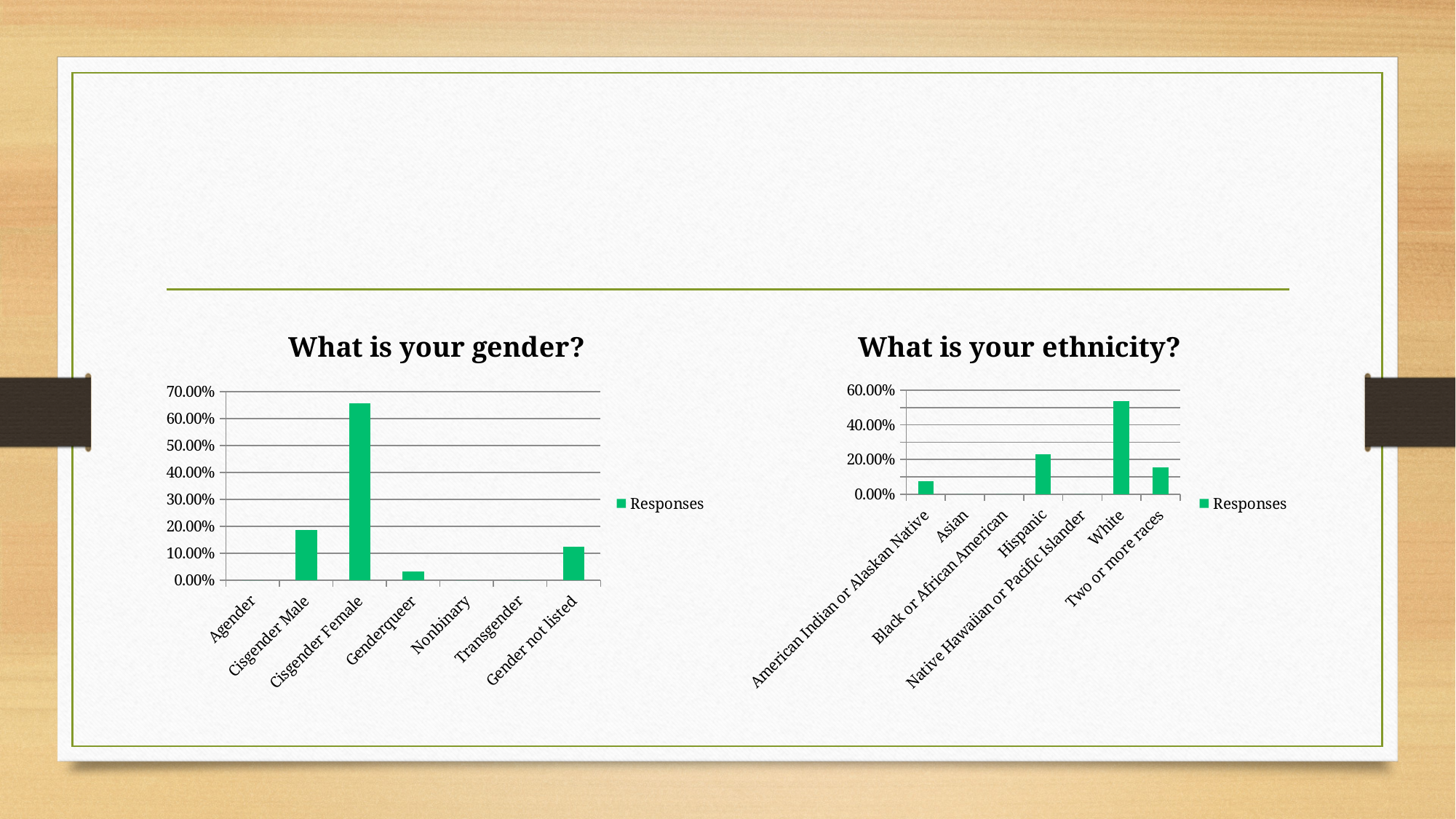
What kind of chart is the 'What is your gender?' chart? Bar chart In the 'What is your gender?' chart, is the value for Genderqueer greater or less than 10.00%? less In the 'What is your ethnicity?' chart, which category has the highest value? White In the 'What is your gender?' chart, which is larger: the value for Cisgender Male or the value for Gender not listed? Cisgender Male In the 'What is your gender?' chart, which category has the highest value? Cisgender Female In the 'What is your gender?' chart, is the value for Cisgender Female greater or less than 60.00%? greater How many categories are shown on the x axis of the 'What is your ethnicity?' chart? 7 How many series does the legend of the 'What is your gender?' chart list? 1 In the 'What is your gender?' chart, is the value for Cisgender Male greater or less than 10.00%? greater In the 'What is your ethnicity?' chart, which is larger: the value for Hispanic or the value for Two or more races? Hispanic